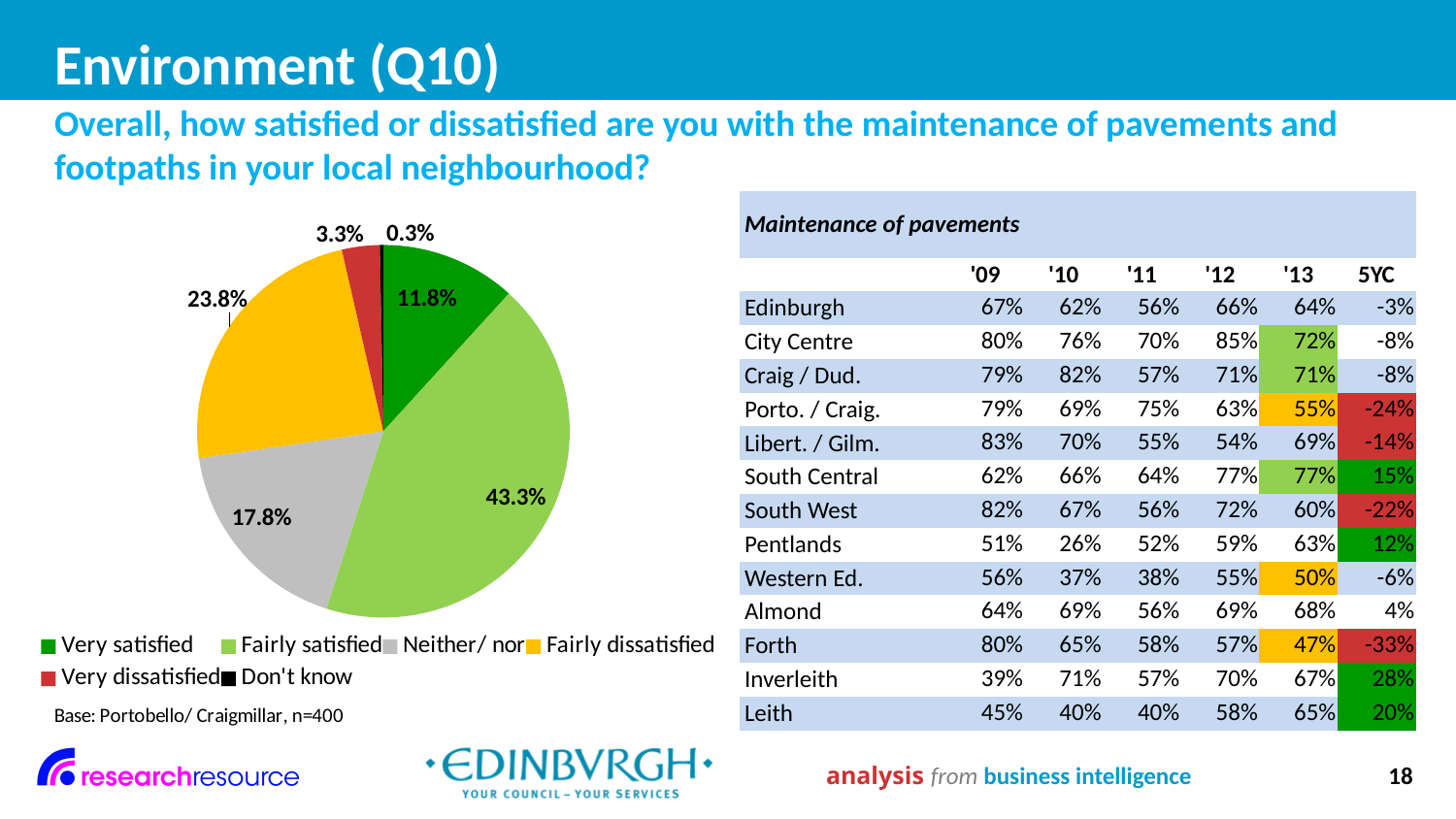
What type of chart is shown on the slide? Pie chart What percentage of respondents are very satisfied? 11.8% Which is larger: the 'Very satisfied' slice or the 'Neither/ nor' slice? Neither/ nor What percentage of respondents are fairly dissatisfied? 23.8% How many response categories does the pie chart legend list? 6 What percentage of respondents are fairly satisfied with the maintenance of pavements and footpaths? 43.3% What share of the pie is 'Neither/ nor'? 17.8% What is the base (sample size) stated below the pie chart? Portobello/ Craigmillar, n=400 What percentage of respondents answered 'Don't know'? 0.3% Which response category has the smallest slice of the pie? Don't know Which response category has the largest slice of the pie? Fairly satisfied What is the difference between the 'Fairly satisfied' and 'Fairly dissatisfied' percentages? 19.5%